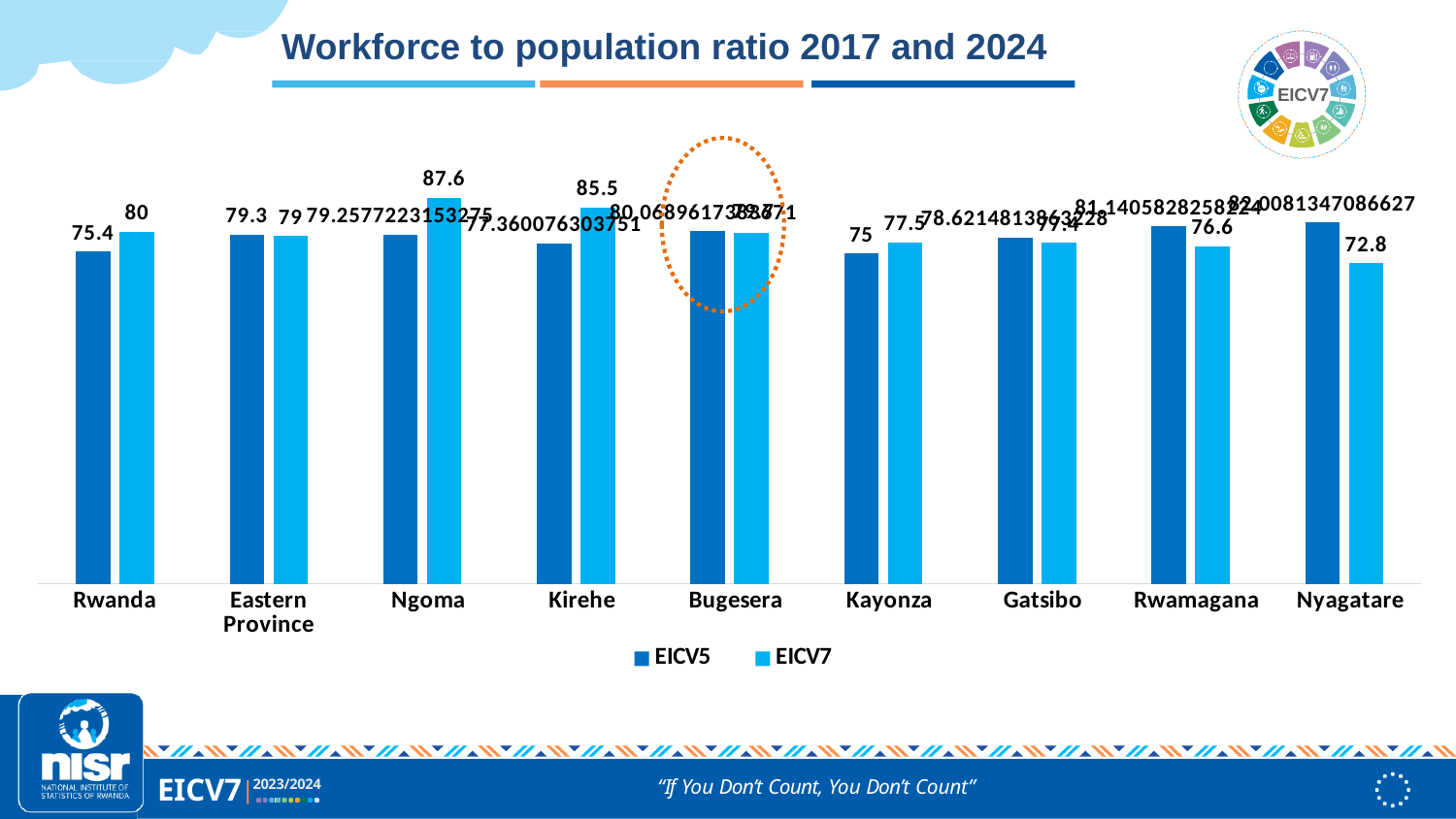
What is the EICV7 value for Rwanda? 80 What is the EICV7 value for Kayonza? 77.5 Which category has the highest EICV7 value? Ngoma How many categories are shown on the x axis? 9 For Nyagatare, which is larger: the EICV5 value or the EICV7 value? EICV5 What is the EICV7 value for Ngoma? 87.6 What is the difference between the EICV7 and EICV5 values for Rwanda? 4.6 What is the EICV7 value for Nyagatare? 72.8 How many series does the legend list? 2 What is the EICV5 value for Rwanda? 75.4 Which category has the lowest EICV7 value? Nyagatare Which category is highlighted with a dashed orange circle? Bugesera